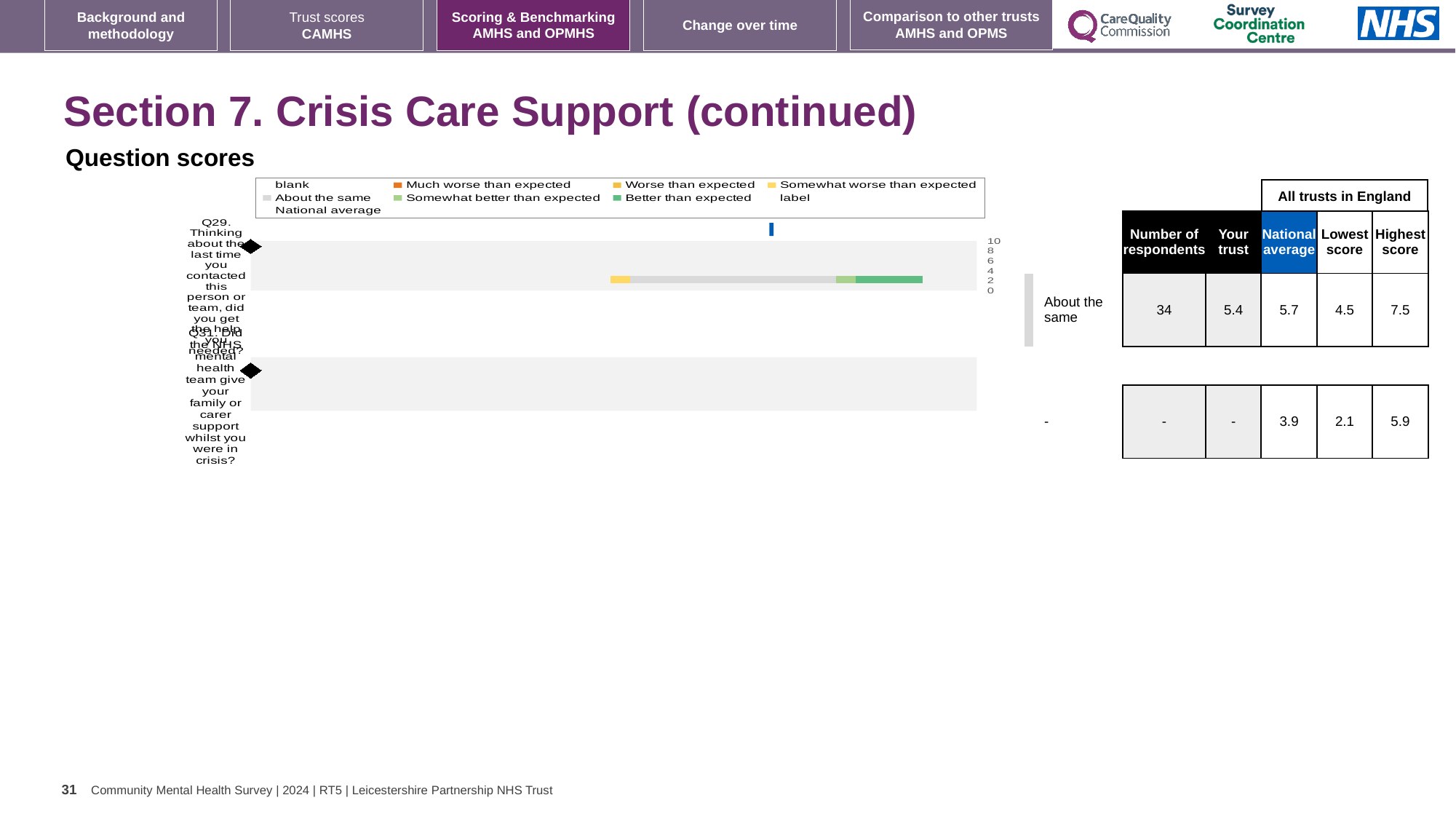
Which question number is the second category on the chart? Q31 What is the highest value shown on the chart's numeric axis? 10 What is the lowest value shown on the chart's numeric axis? 0 How many questions (categories) are plotted on the chart? 2 What kind of chart is shown under 'Question scores'? bar chart How many entries does the chart's legend list? 9 Which question number is the first category on the chart? Q29